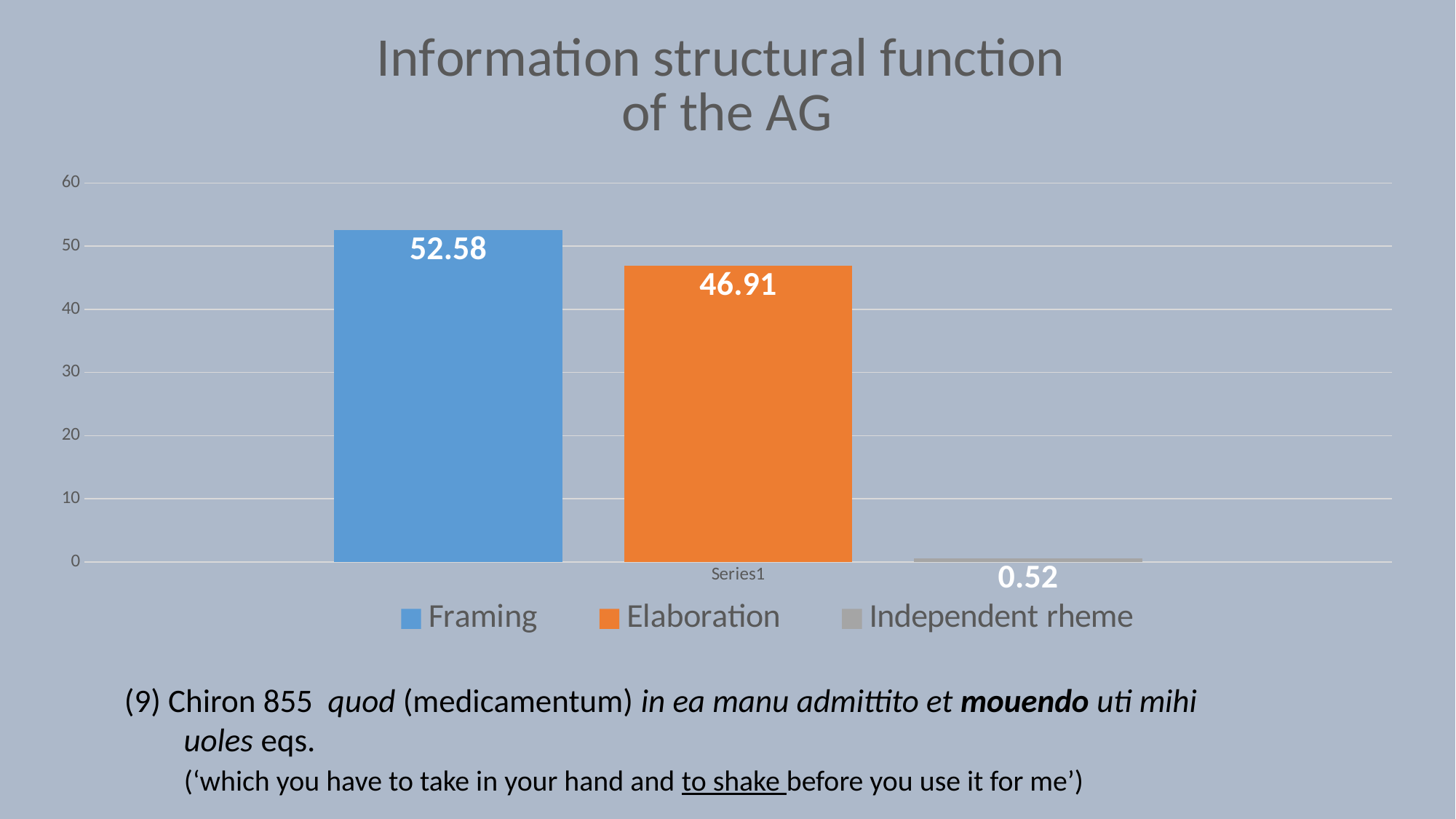
What is the difference between the values for Framing and Elaboration? 5.67 What is the value for Independent rheme? 0.52 What kind of chart is shown on the slide? bar chart What is the difference between the values for Elaboration and Independent rheme? 46.39 Which series has the highest value? Framing Is the value for Elaboration greater or less than 50? less What is the title of the chart? Information structural function of the AG Which series has the lowest value? Independent rheme Which is larger, the value for Framing or the value for Elaboration? Framing What is the value for Elaboration? 46.91 What is the value for Framing? 52.58 How many series does the legend list? 3